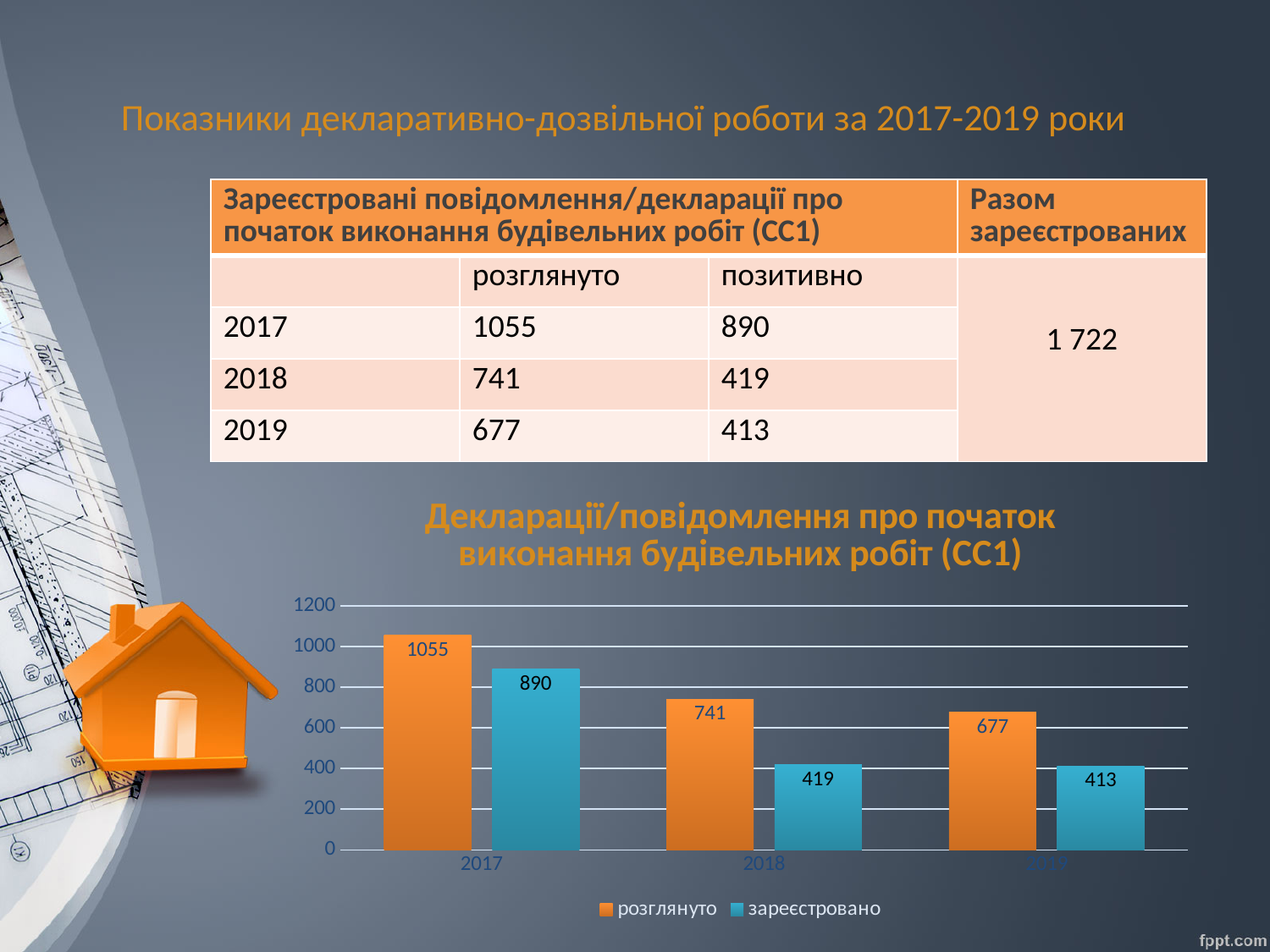
What is the difference between розглянуто and зареєстровано in 2018? 322 What is the value of розглянуто for 2019 in the chart? 677 Which year has the lowest value for зареєстровано? 2019 How many series does the chart legend list? 2 What is the value of розглянуто for 2017 in the chart? 1055 Do the values for розглянуто rise or fall from 2017 to 2019? fall What is the value of зареєстровано for 2018 in the chart? 419 What is the value of зареєстровано for 2017 in the chart? 890 What type of chart is shown on the slide? bar chart How many years are shown on the x axis of the chart? 3 Which year has the highest value for розглянуто? 2017 Which is larger in 2017: розглянуто or зареєстровано? розглянуто